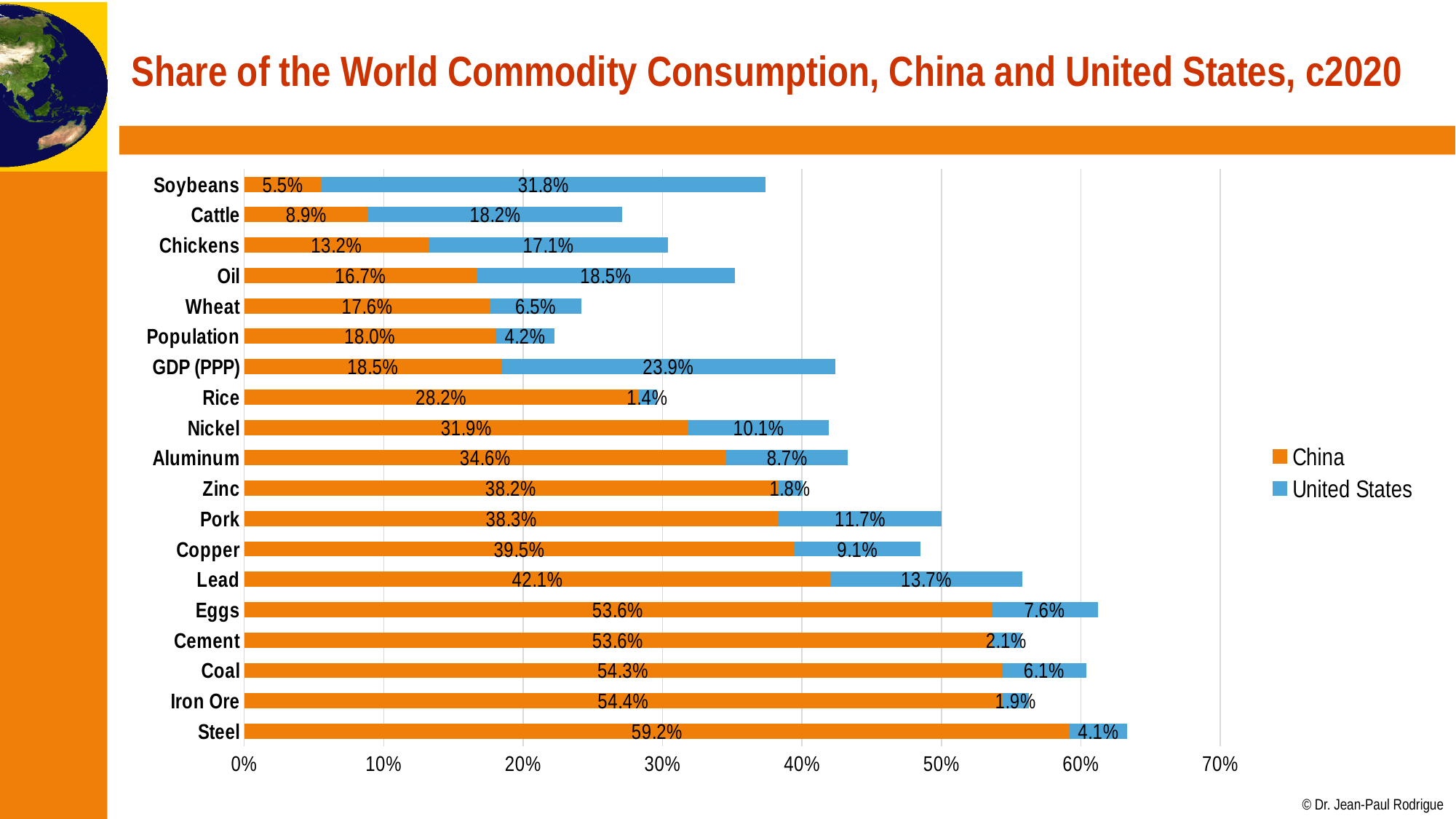
What is the United States' share of world GDP (PPP)? 23.9% How many series does the legend list? 2 What is the difference between the United States' and China's shares for Soybeans? 26.3 percentage points Which category has the highest value for China? Steel What type of chart is shown on the slide? Stacked bar chart What is China's share of world soybean consumption? 5.5% Which category has the highest value for the United States? Soybeans Which category has the lowest value for the United States? Rice What is the combined share of China and the United States for Steel? 63.3% Which is larger for Oil: China's share or the United States' share? United States What is China's share of world copper consumption? 39.5% How many categories are shown on the chart? 19